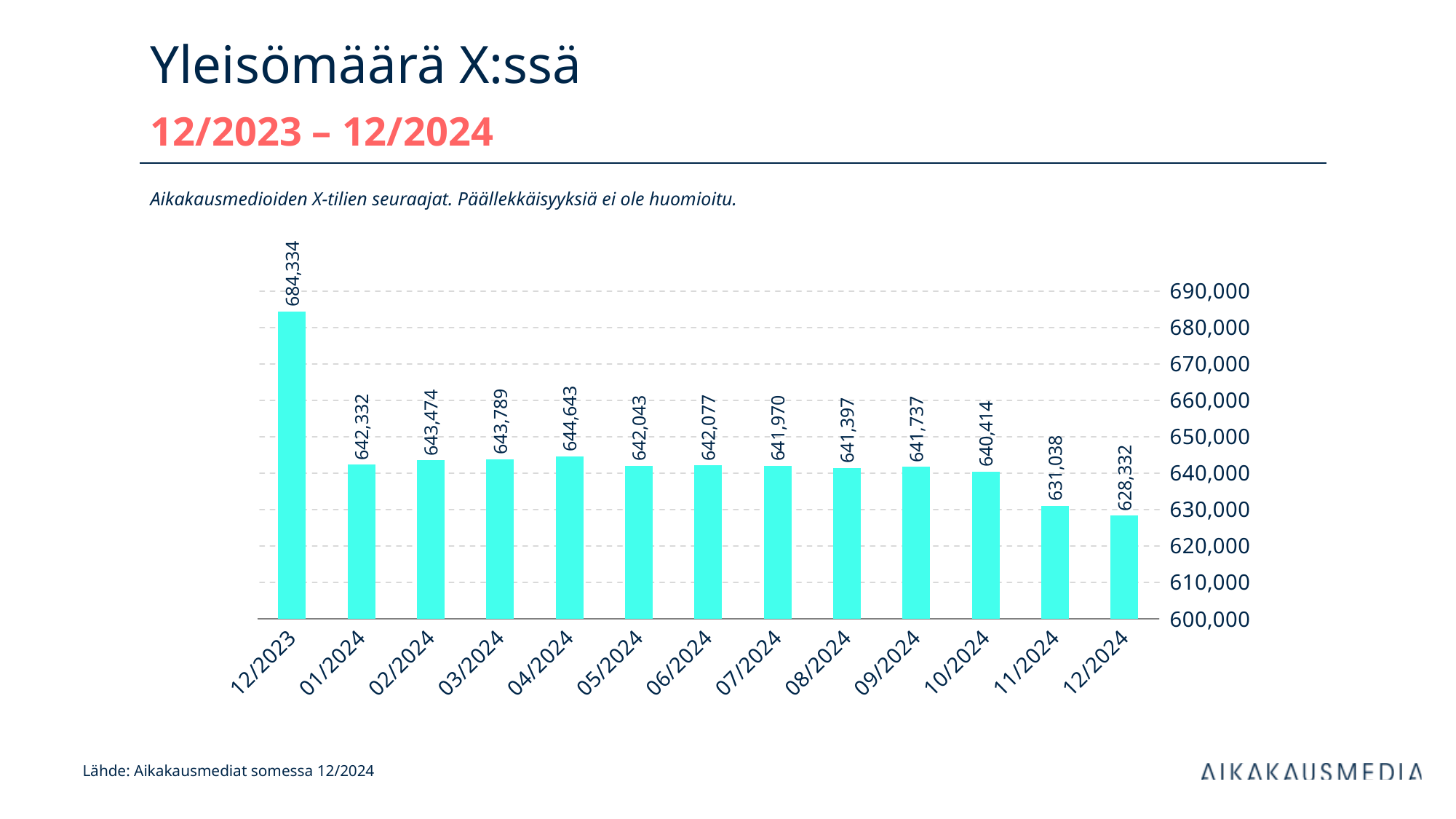
Which month has the highest value? 12/2023 What is the value for 04/2024? 644,643 What is the difference between the values for 11/2024 and 12/2024? 2,706 Which month has the lowest value? 12/2024 What is the value for 12/2024? 628,332 Which is larger, the value for 04/2024 or the value for 10/2024? 04/2024 What is the difference between the values for 12/2023 and 12/2024? 56,002 Is the value for 11/2024 greater or less than 640,000? less What is the value for 12/2023? 684,334 What is the title of the chart on the slide? Yleisömäärä X:ssä What kind of chart is shown on the slide? bar chart How many months are shown on the x axis? 13